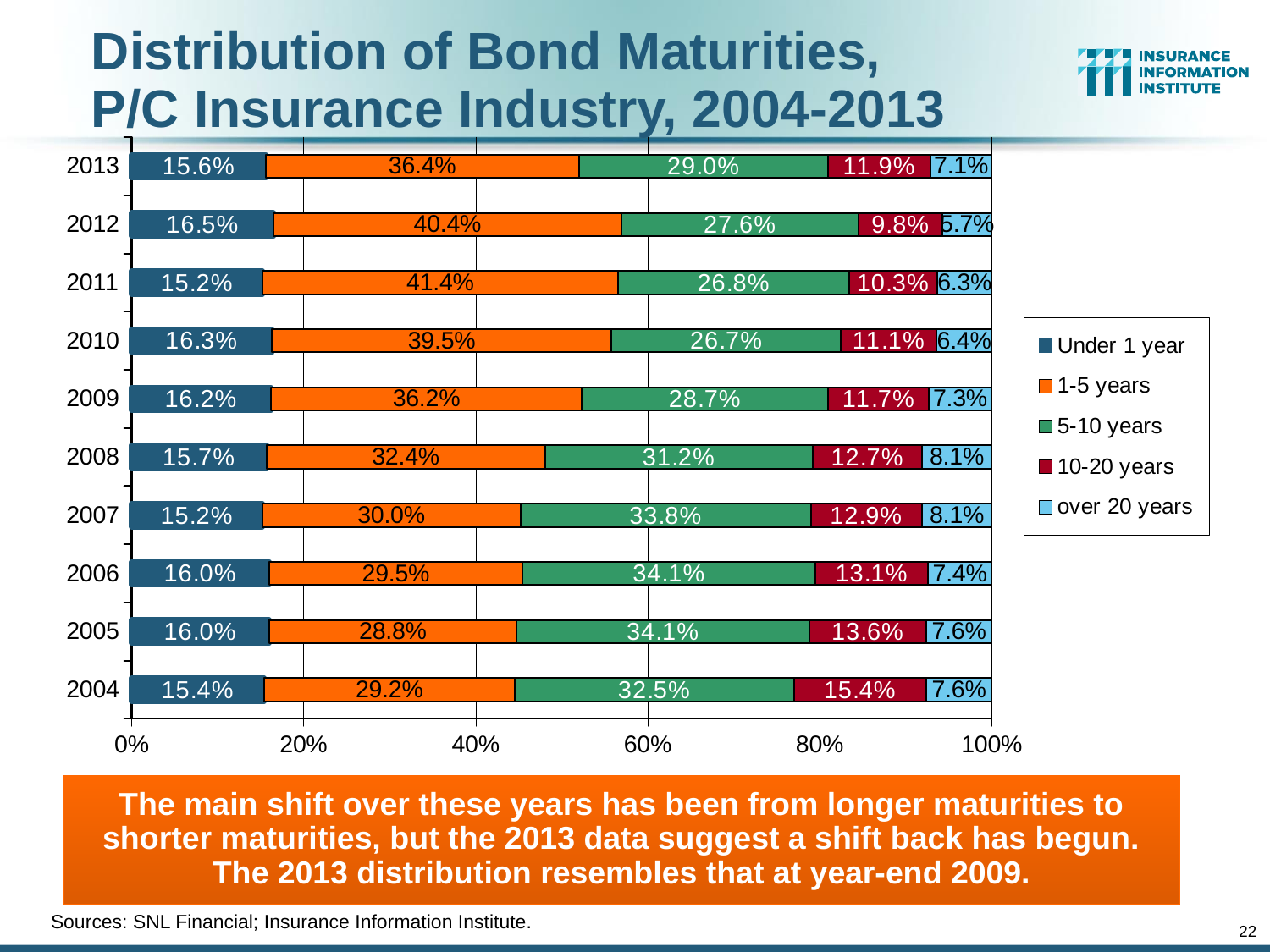
How many years are shown on the chart? 10 What is the 10-20 years value for 2004? 15.4% How many percentage points higher is the 1-5 years share in 2013 than in 2004? 7.2 percentage points In which year was the 1-5 years share the highest? 2011 What share of bonds had maturities over 20 years in 2012? 5.7% In which year was the over 20 years share the lowest? 2012 How many maturity categories does the legend list? 5 Did the 10-20 years share generally rise or fall from 2004 to 2012? Fall Which is larger: the 5-10 years share in 2006 or in 2013? 2006 What percentage of bonds had a maturity of 1-5 years in 2013? 36.4% What is the value for the 5-10 years category in 2007? 33.8% What type of chart is shown on the slide? Stacked bar chart